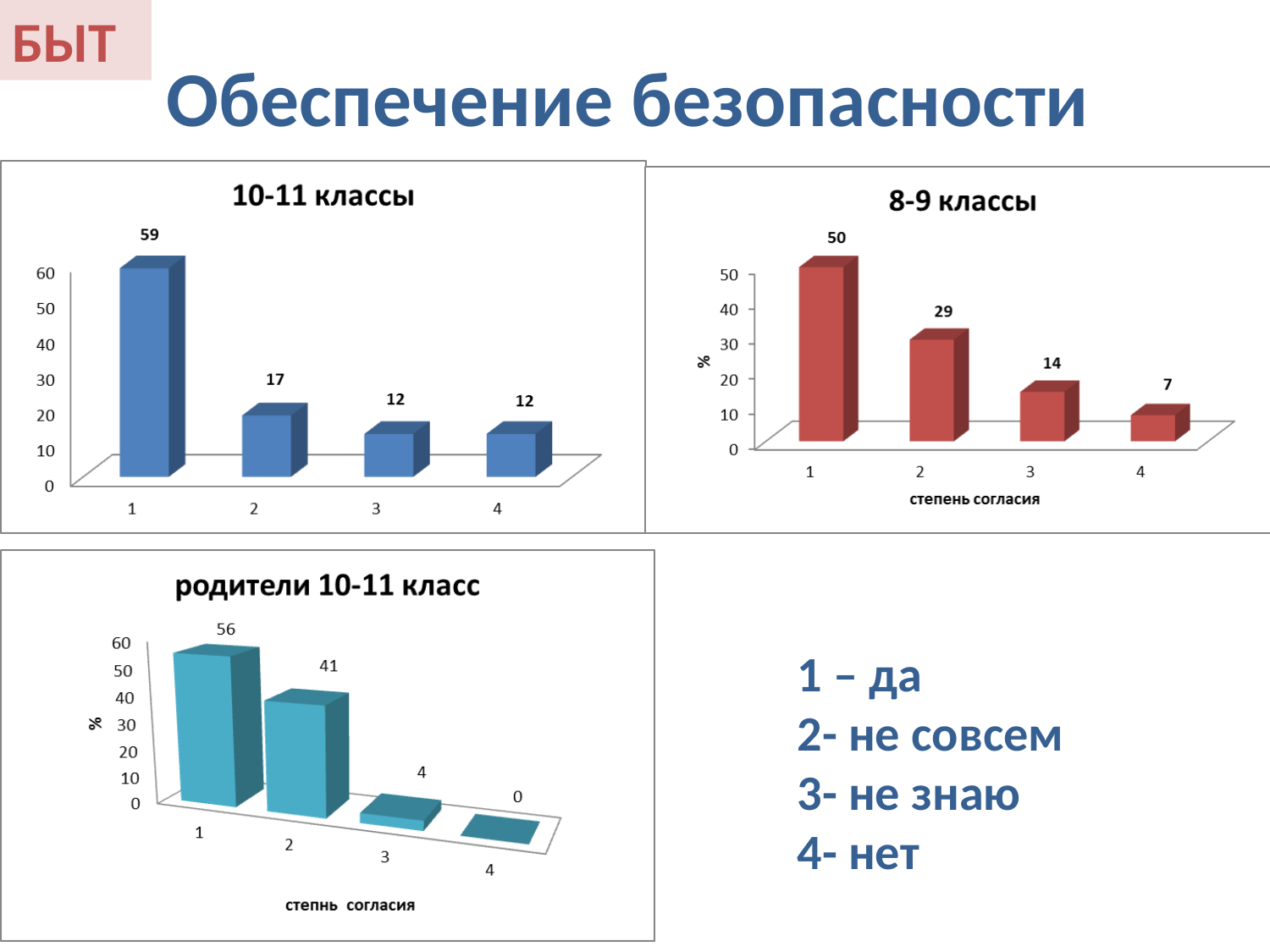
In the "10-11 классы" chart, what is the value for category 2? 17 In the "родители 10-11 класс" chart, what is the value for category 4? 0 In the "10-11 классы" chart, what is the value for category 1? 59 What kind of chart is the "8-9 классы" chart? bar chart In the "8-9 классы" chart, do the values rise or fall from category 1 to category 4? fall In the "родители 10-11 класс" chart, which category has the highest value? 1 In the "8-9 классы" chart, which category has the lowest value? 4 In the "родители 10-11 класс" chart, is the value for category 1 larger or smaller than the value for category 2? larger How many categories are shown in the "10-11 классы" chart? 4 In the "8-9 классы" chart, what is the difference between the values for category 1 and category 2? 21 In the "8-9 классы" chart, what is the value for category 3? 14 In the "родители 10-11 класс" chart, what is the value for category 2? 41